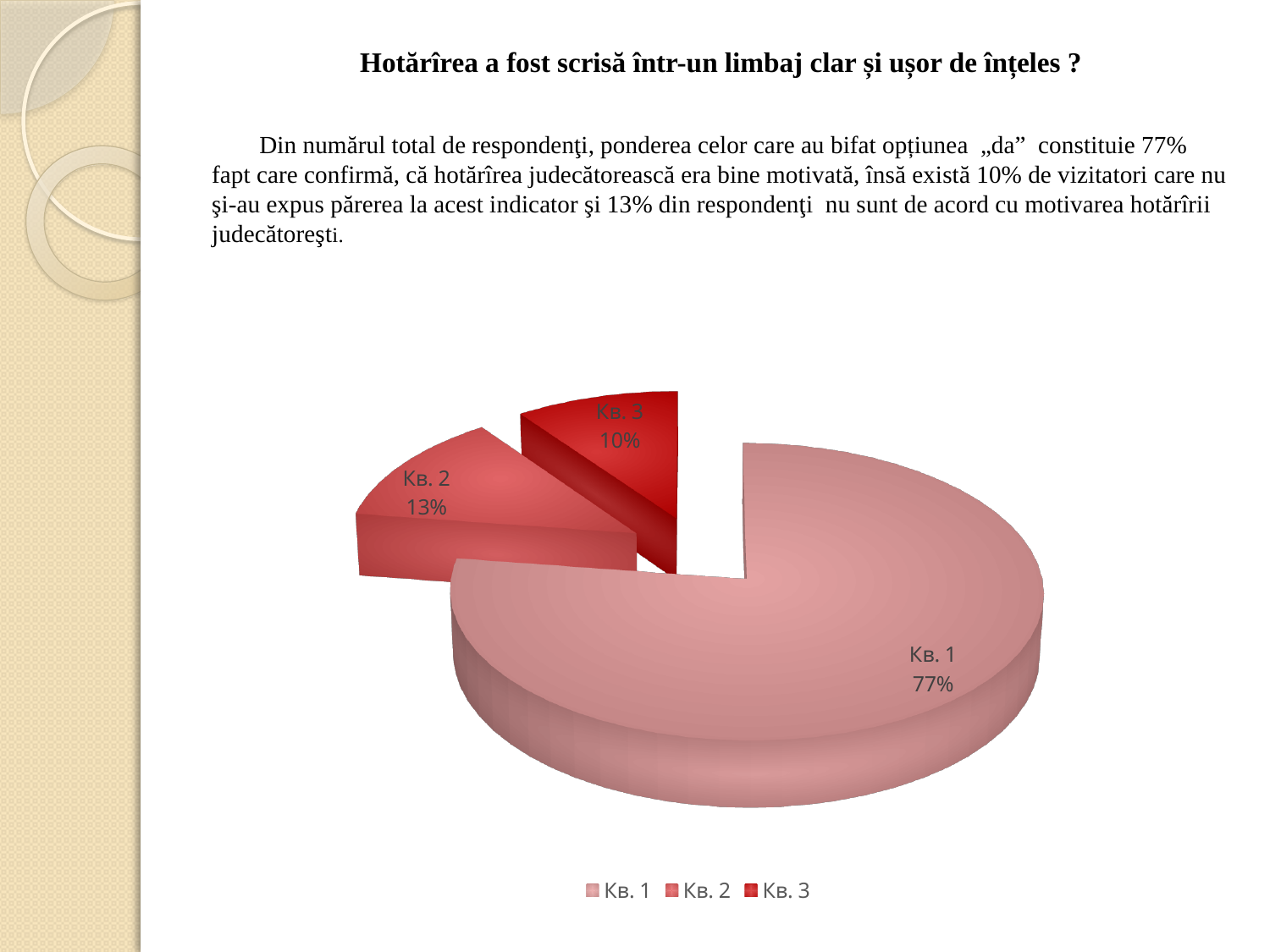
Which slice is the largest? Кв. 1 What is the value for Кв. 1? 77% What kind of chart is shown on the slide? pie chart Which is larger, Кв. 2 or Кв. 3? Кв. 2 How many entries does the legend list? 3 What is the difference between the values for Кв. 1 and Кв. 2? 64% Which slice is the smallest? Кв. 3 What is the difference between the values for Кв. 2 and Кв. 3? 3% How many slices does the pie chart have? 3 What is the value for Кв. 2? 13% What share of the pie does Кв. 1 represent? 77% What is the value for Кв. 3? 10%